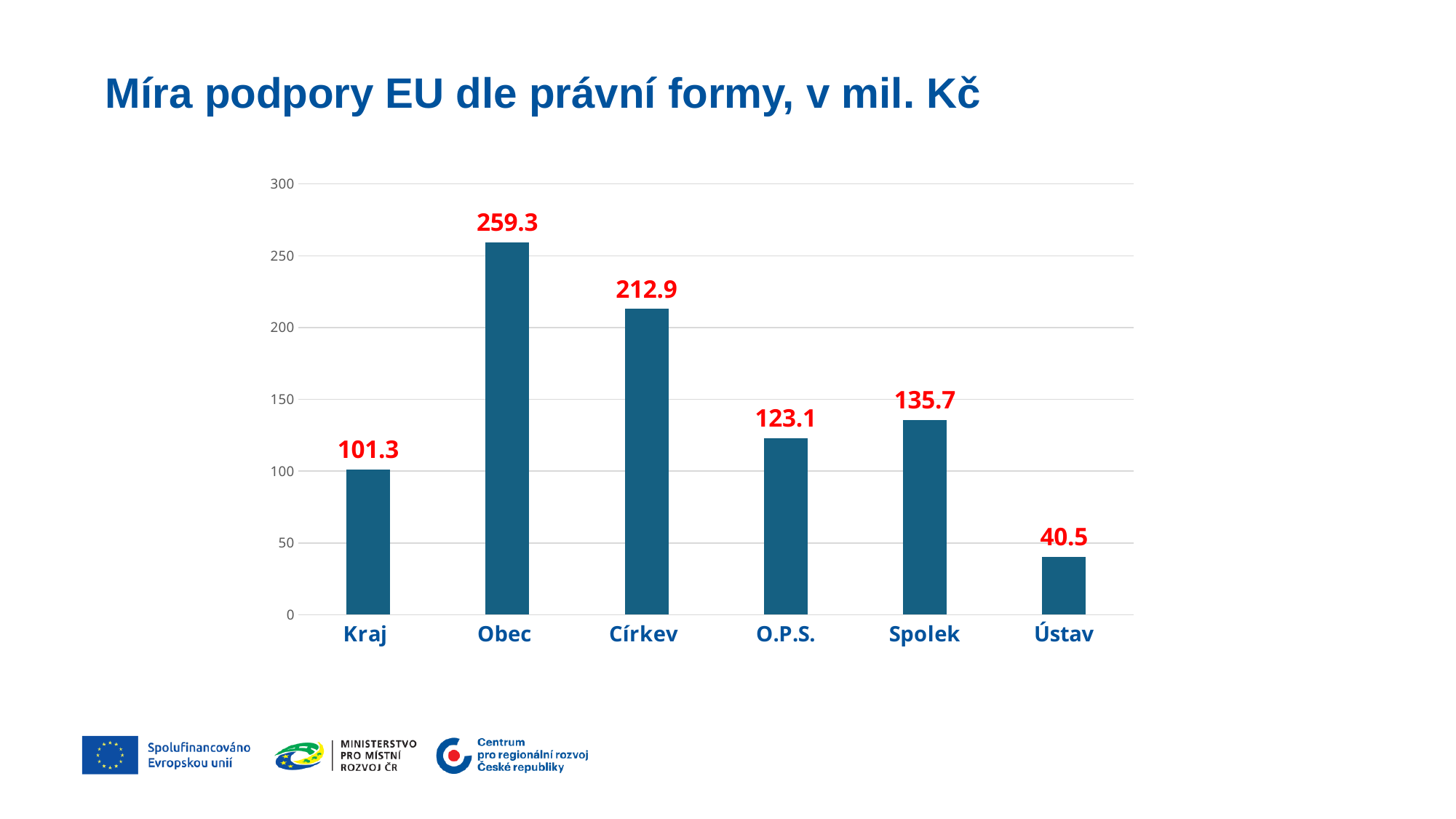
What is the difference between the values for Obec and Církev? 46.4 What is the value for Obec? 259.3 How many categories are shown on the x axis? 6 What is the value for Ústav? 40.5 Which category has the highest value? Obec What is the difference between the values for Spolek and O.P.S.? 12.6 Which category has the lowest value? Ústav Which is larger, the value for Kraj or the value for O.P.S.? O.P.S. Is the value for Církev greater or less than 200? greater What kind of chart is shown on the slide? bar chart What is the value for Spolek? 135.7 What is the title of the chart? Míra podpory EU dle právní formy, v mil. Kč